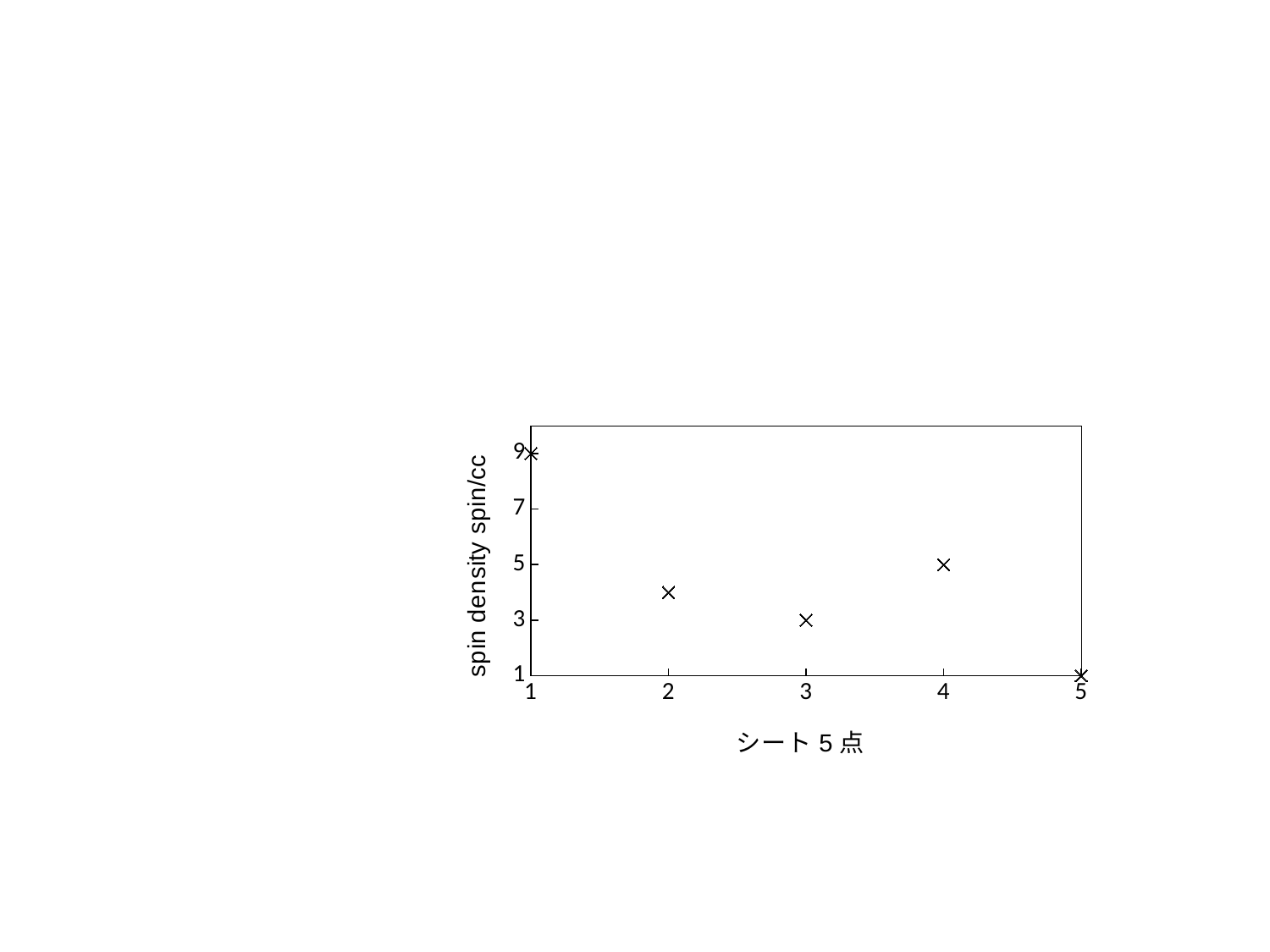
What is the spin density value at x = 1? 9 What is the label on the vertical axis of the chart? spin density spin/cc What kind of chart is shown on the slide? scatter chart How many data points are plotted in the chart? 5 What is the difference between the spin density at x = 1 and at x = 5? 8 At which x value is the spin density lowest? 5 Is the spin density at x = 2 greater or less than 3? greater What is the spin density value at x = 3? 3 Which has the larger spin density, x = 3 or x = 4? 4 At which x value is the spin density highest? 1 What is the spin density value at x = 4? 5 What is the spin density value at x = 5? 1